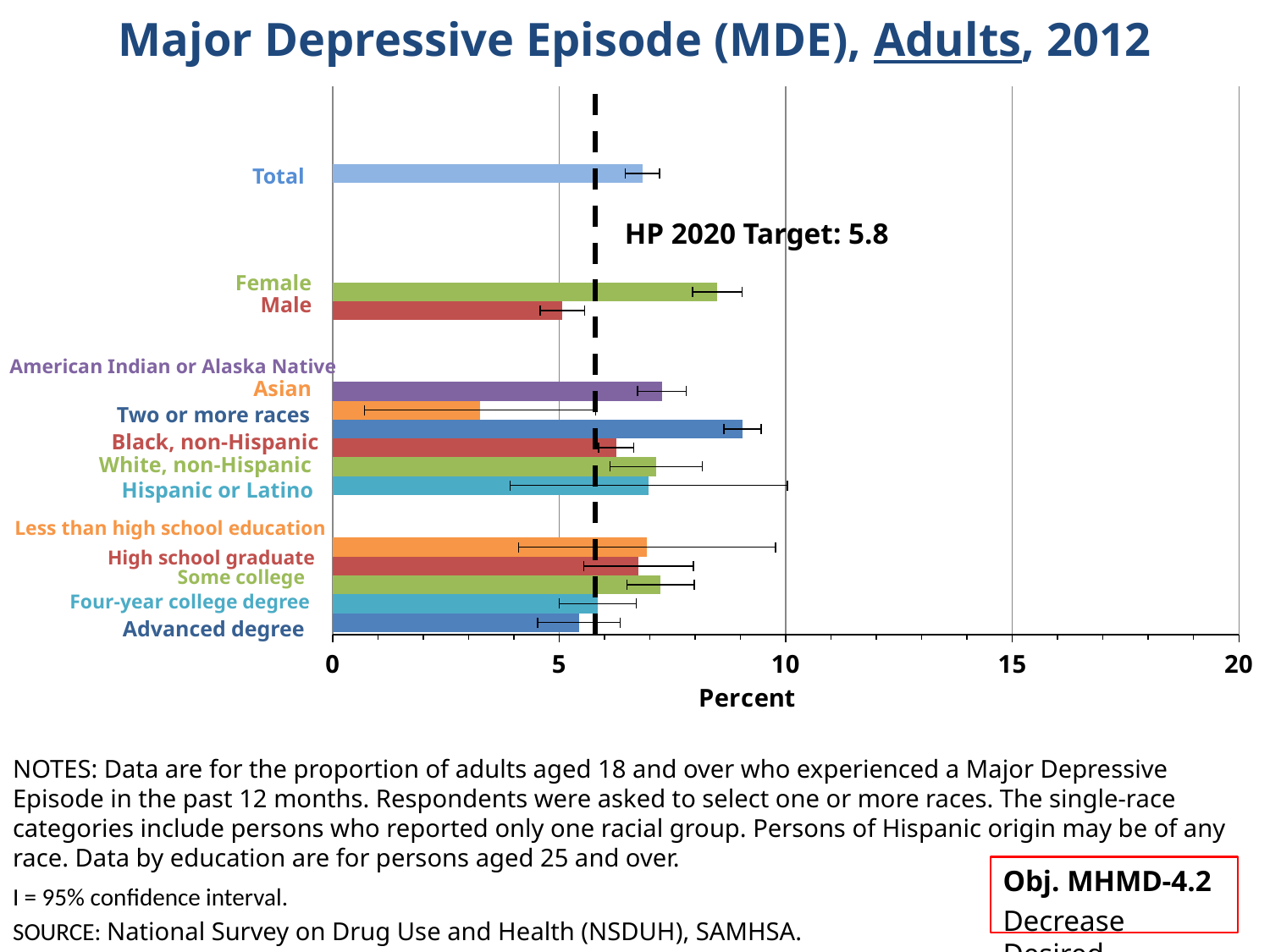
Which category has the shortest bar on the chart? Asian Is the value for Total greater or less than 5? greater What kind of chart is shown on the slide? bar chart Which is larger, the value for Less than high school education or the value for Advanced degree? Less than high school education Is the value for Female greater or less than 5? greater Which category has the longest bar on the chart? Two or more races Which is larger, the value for Female or the value for Male? Female Is the value for Asian greater or less than 5? less What is the label of the horizontal axis? Percent How many education categories are plotted on the chart? 5 What is the HP 2020 Target value shown on the chart? 5.8